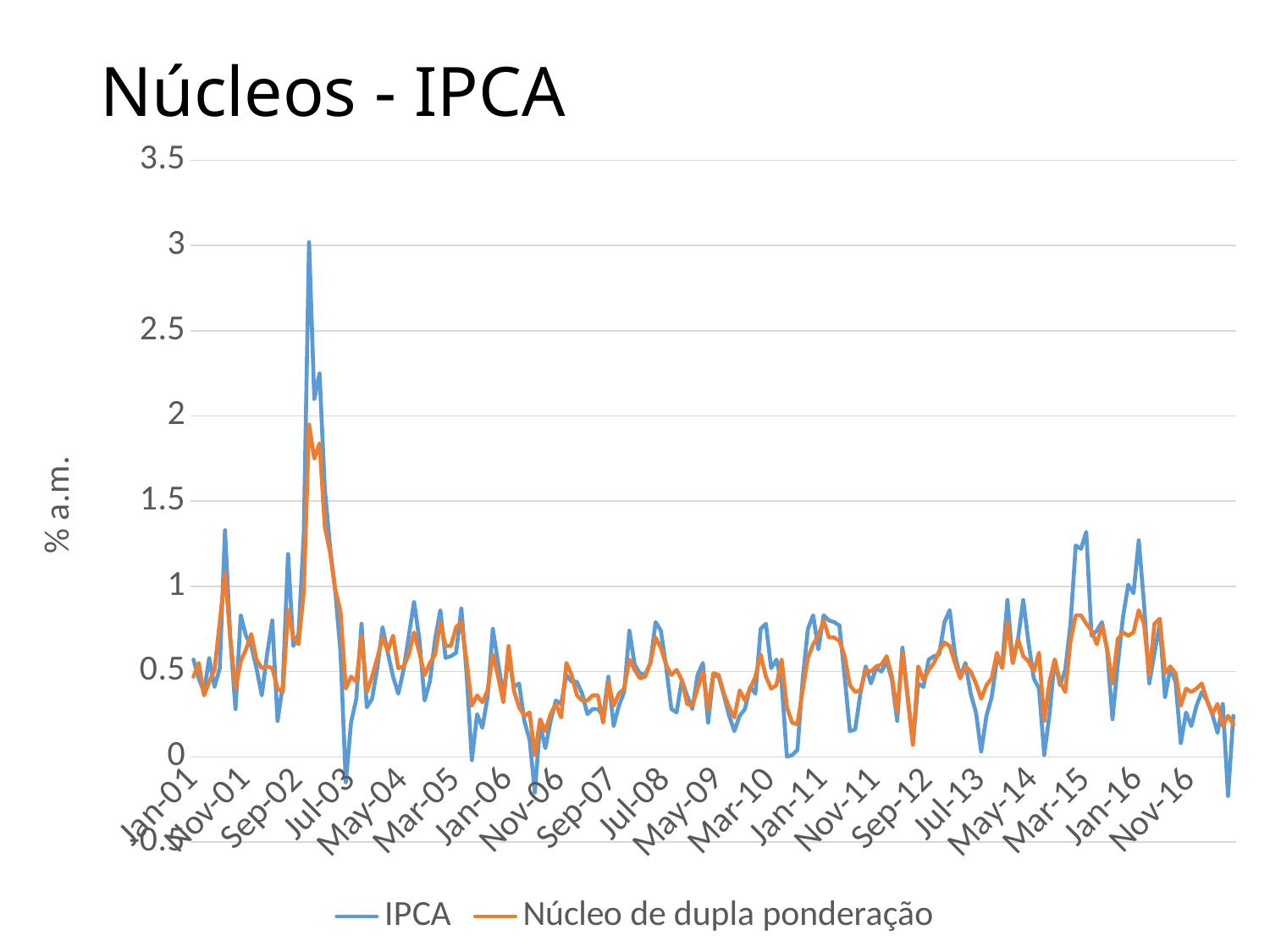
Does the IPCA series rise or fall from its peak around 2003 to May-04? fall Is the lowest value of the IPCA series greater or less than 0.5? less Which series reaches the higher peak, IPCA or Núcleo de dupla ponderação? IPCA Is the highest value reached by the Núcleo de dupla ponderação series greater or less than 2.5? less Is the highest value reached by the IPCA series greater or less than 2.5? greater What is the highest value shown on the y axis? 3.5 What kind of chart is shown on the slide? line chart How many date labels are shown along the x axis? 20 What is the title of the chart? Núcleos - IPCA How many series does the legend list? 2 What are the two series named in the legend? IPCA and Núcleo de dupla ponderação